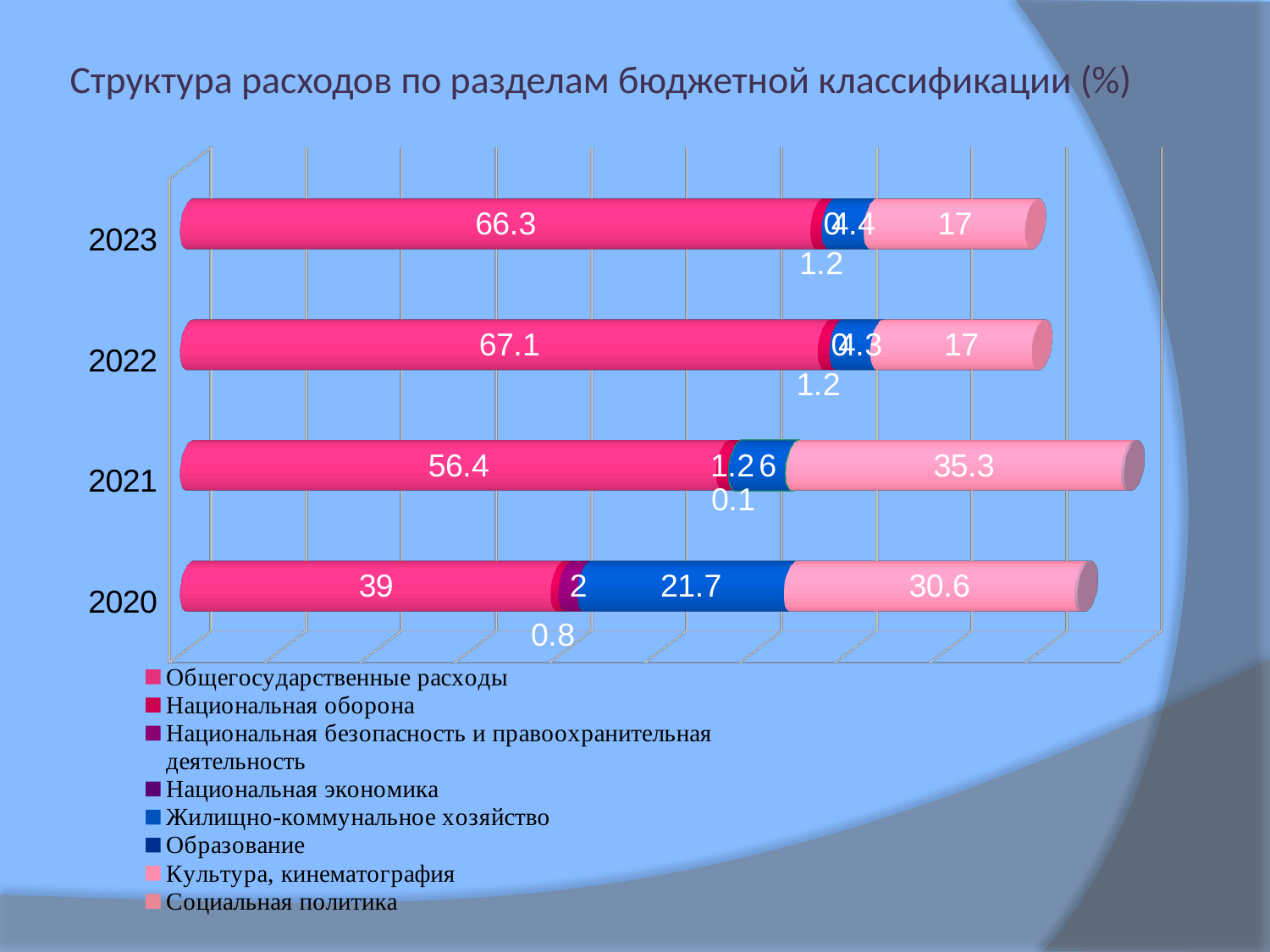
What is the value for Общегосударственные расходы in 2022? 67.1 What is the title of the chart? Структура расходов по разделам бюджетной классификации (%) What is the value for Общегосударственные расходы in 2020? 39 What kind of chart is shown on the slide? bar chart In which year is the value for Общегосударственные расходы the lowest? 2020 Which year has the larger value for Общегосударственные расходы, 2021 or 2020? 2021 In which year is the value for Общегосударственные расходы the highest? 2022 What is the value of the rightmost (light pink) segment of the 2021 bar? 35.3 What is the value for Общегосударственные расходы in 2023? 66.3 How many series does the legend list? 8 What is the difference between the Общегосударственные расходы values for 2022 and 2023? 0.8 How many years are shown on the chart? 4